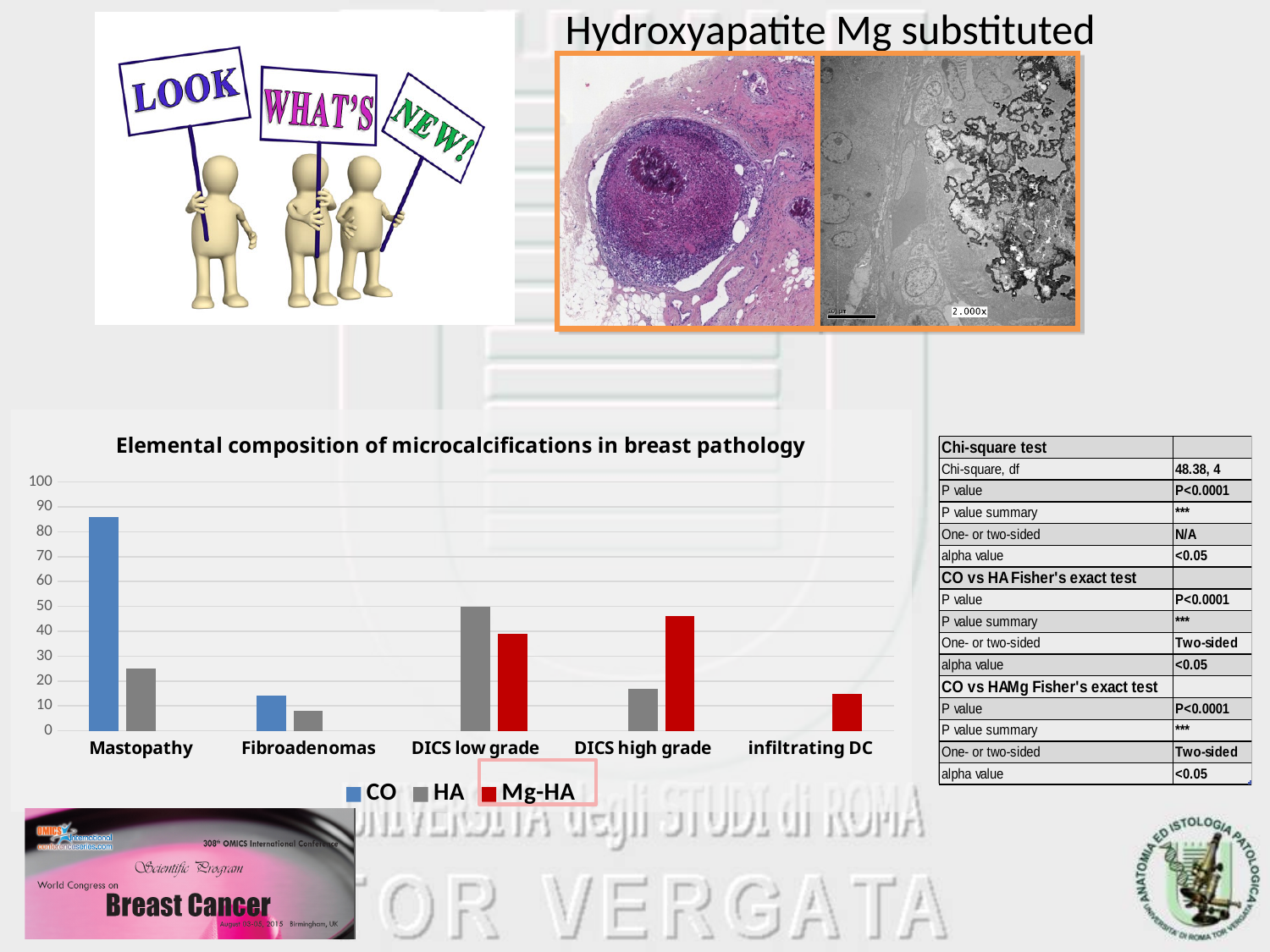
Is the Mg-HA value for DICS high grade greater or less than 40? greater What is the title of the chart? Elemental composition of microcalcifications in breast pathology How many series does the chart legend list? 3 Is the CO value for Mastopathy greater or less than 80? greater For DICS high grade, which is larger: the HA value or the Mg-HA value? Mg-HA Is the HA value for Fibroadenomas greater or less than 10? less For DICS low grade, which is larger: the HA value or the Mg-HA value? HA What kind of chart is shown on the slide? bar chart Which category has the tallest bar in the chart? Mastopathy How many categories are shown on the x axis of the chart? 5 Which series is shown in red in the chart? Mg-HA